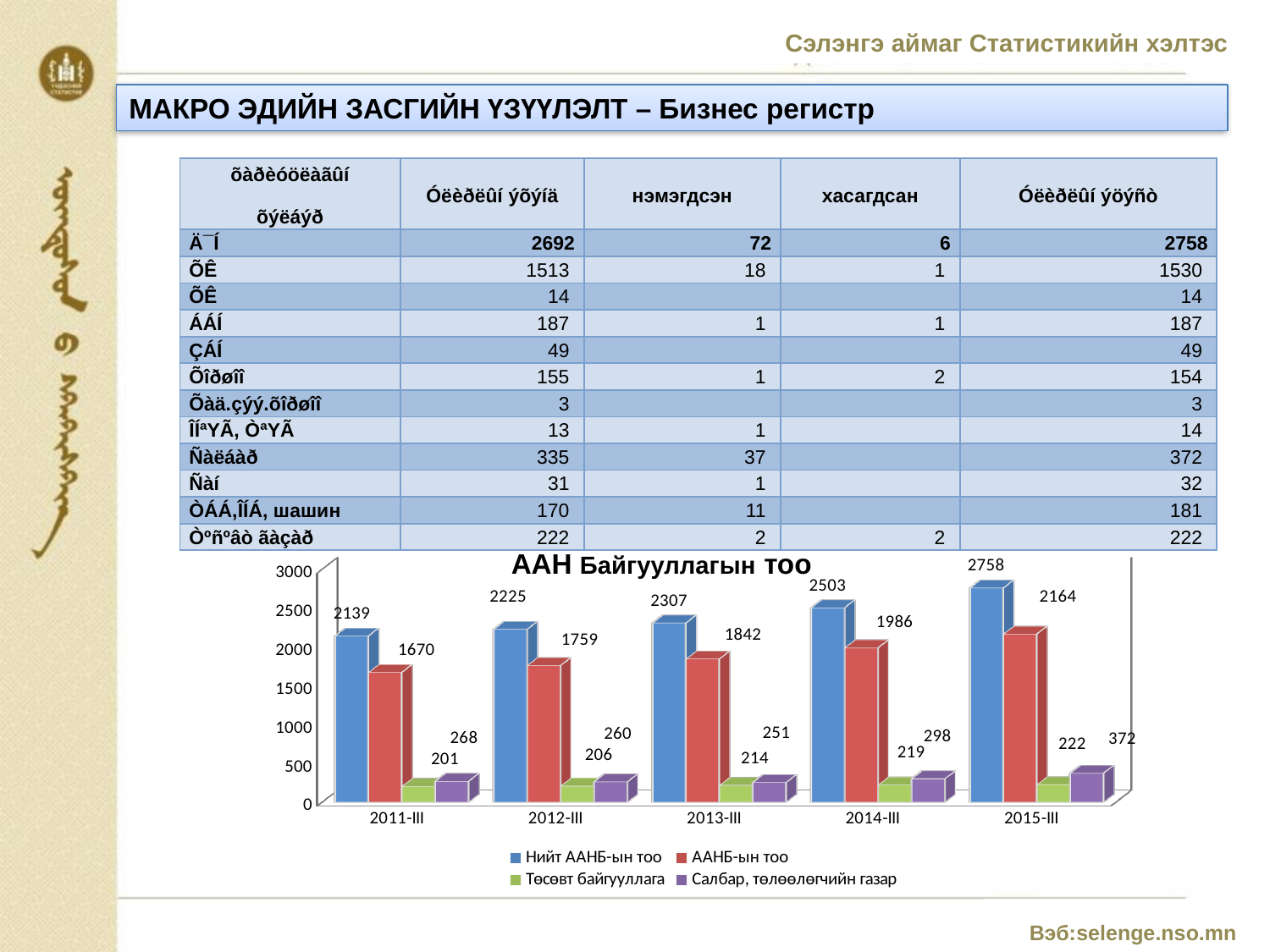
What is the value of Төсөвт байгууллага for 2011-III? 201 What is the value of Салбар, төлөөлөгчийн газар for 2014-III? 298 Does Нийт ААНБ-ын тоо rise or fall from 2011-III to 2015-III? Rise What is the value of Нийт ААНБ-ын тоо for 2015-III? 2758 What kind of chart is shown on the slide? Bar chart Which is larger: ААНБ-ын тоо in 2012-III or in 2011-III? 2012-III How many periods are shown on the x axis of the chart? 5 In which period is Нийт ААНБ-ын тоо highest? 2015-III What is the value of ААНБ-ын тоо for 2013-III? 1842 In which period is Салбар, төлөөлөгчийн газар lowest? 2013-III How many series does the chart legend list? 4 What is the difference between Нийт ААНБ-ын тоо in 2015-III and 2014-III? 255